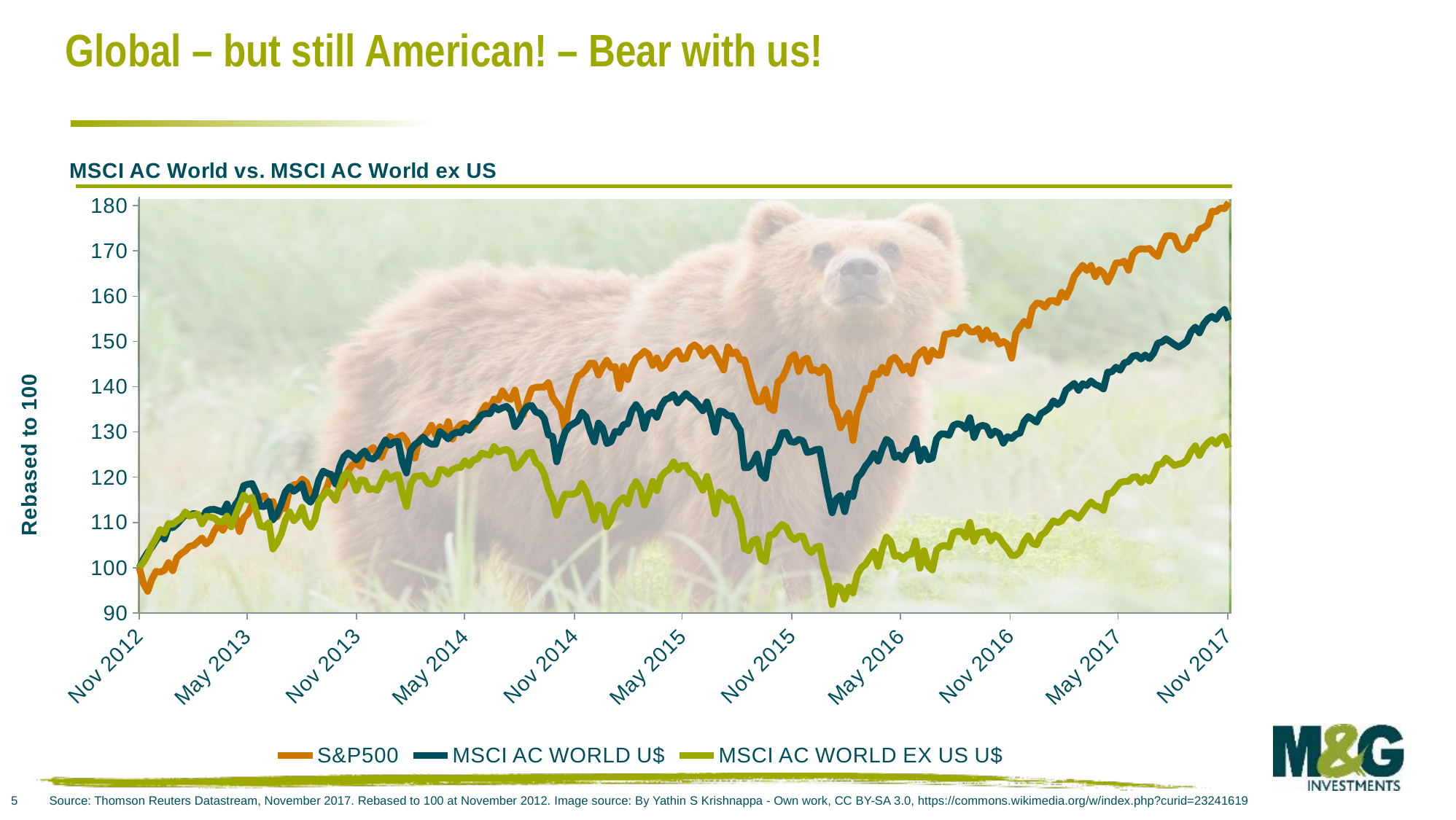
Which series has the lowest value at Nov 2017? MSCI AC WORLD EX US U$ What kind of chart is shown on the slide? line chart How many series does the legend list? 3 Is the value for MSCI AC WORLD EX US U$ at Nov 2017 greater or less than 140? less Does the S&P500 series overall rise or fall from Nov 2012 to Nov 2017? rise Is the value for MSCI AC WORLD U$ at Nov 2017 greater or less than 150? greater Is the value for S&P500 at Nov 2017 greater or less than 170? greater Which series has the highest value at Nov 2017? S&P500 At Nov 2017, which is larger: S&P500 or MSCI AC WORLD EX US U$? S&P500 What is the title of the chart? MSCI AC World vs. MSCI AC World ex US What is the label on the vertical axis of the chart? Rebased to 100